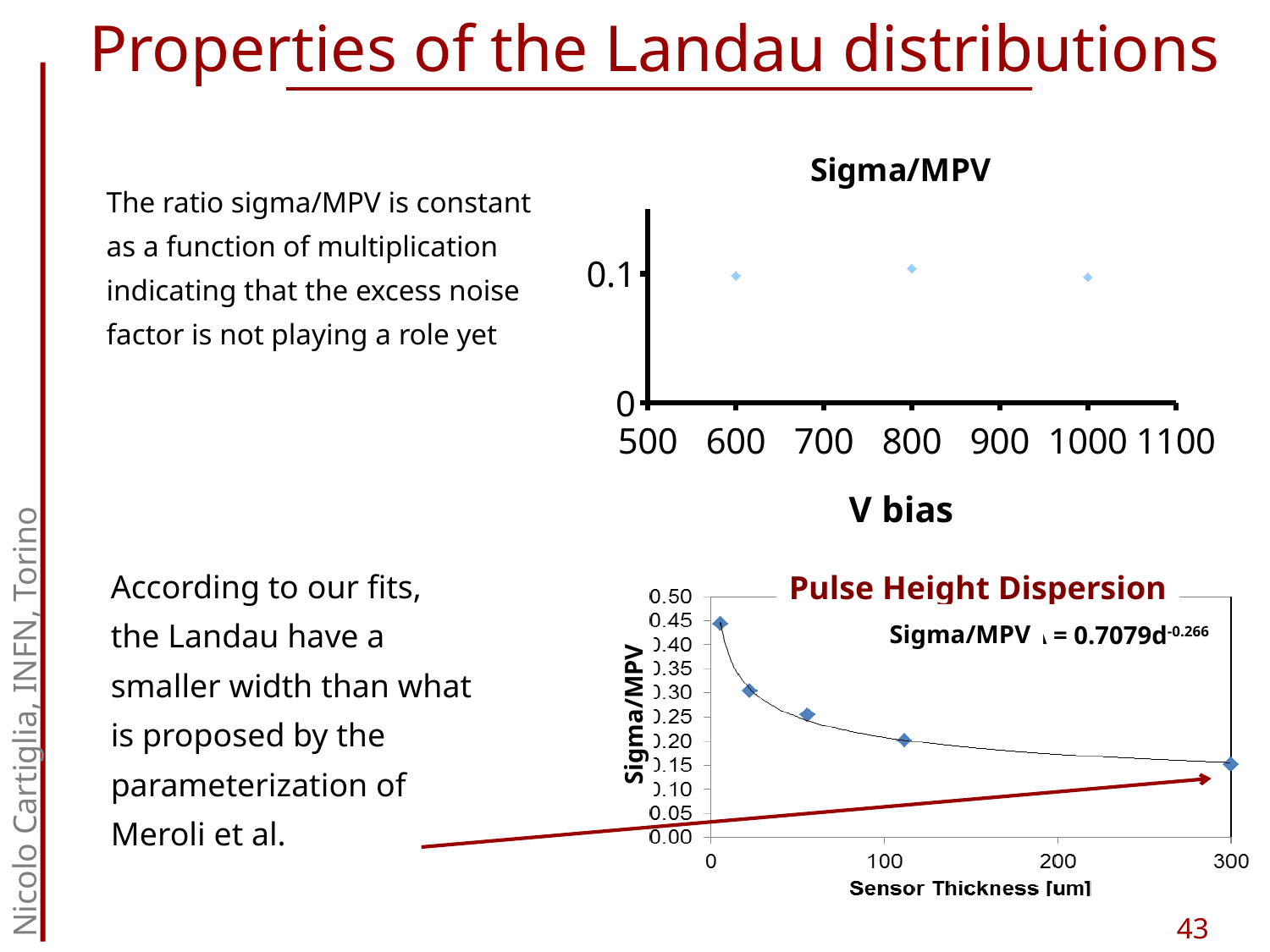
In the bottom 'Pulse Height Dispersion' chart, is the Sigma/MPV value of the leftmost point (thinnest sensor) greater or less than 0.40? greater In the bottom 'Pulse Height Dispersion' chart, which point has the highest Sigma/MPV: the thinnest sensor or the 300 um sensor? the thinnest sensor What kind of chart is the top chart titled 'Sigma/MPV'? scatter chart How many data points are plotted in the top 'Sigma/MPV' chart? 3 What fit equation is shown on the bottom 'Pulse Height Dispersion' chart? Sigma/MPV = 0.7079d^-0.266 In the top 'Sigma/MPV' chart, do the values change strongly or stay roughly constant as V bias increases from 600 to 1000? stay roughly constant In the bottom 'Pulse Height Dispersion' chart, does Sigma/MPV rise or fall as sensor thickness increases? fall What is the x-axis label of the top 'Sigma/MPV' chart? V bias How many data points are plotted in the bottom 'Pulse Height Dispersion' chart? 5 In the bottom 'Pulse Height Dispersion' chart, is the Sigma/MPV value at a sensor thickness of 300 um greater or less than 0.25? less